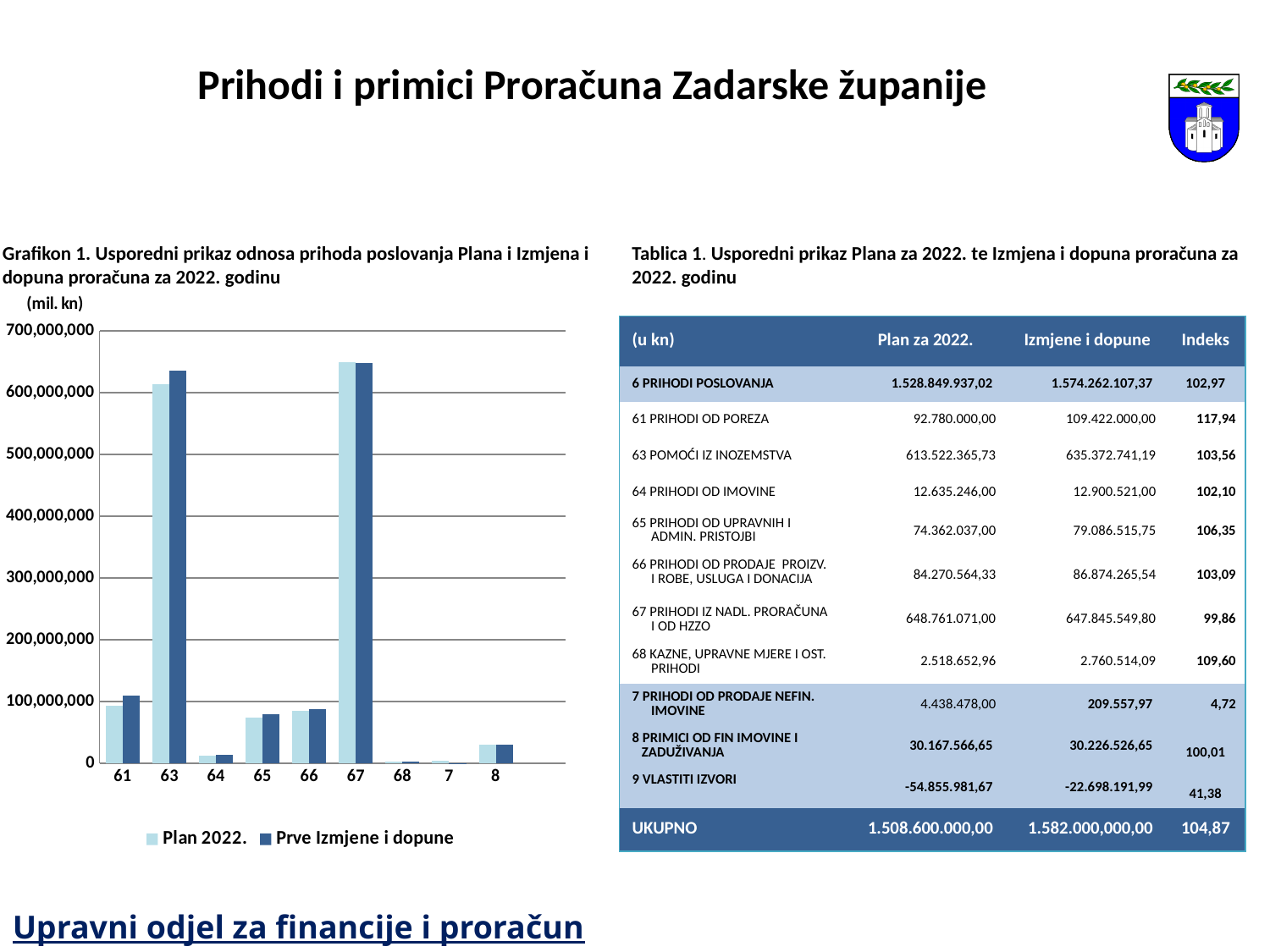
For category 63, which series has the larger value, Plan 2022. or Prve Izmjene i dopune? Prve Izmjene i dopune How many series does the chart's legend list? 2 Is the Prve Izmjene i dopune value for category 61 greater or less than 100,000,000? greater Is the Plan 2022. value for category 65 greater or less than 100,000,000? less For category 61, which series has the larger value, Plan 2022. or Prve Izmjene i dopune? Prve Izmjene i dopune How many categories are shown on the x axis of the chart? 9 Which category has the highest value for the Plan 2022. series? 67 Is the Prve Izmjene i dopune value for category 67 greater or less than 600,000,000? greater What kind of chart is shown on the slide? bar chart What are the two series named in the chart's legend? Plan 2022. and Prve Izmjene i dopune